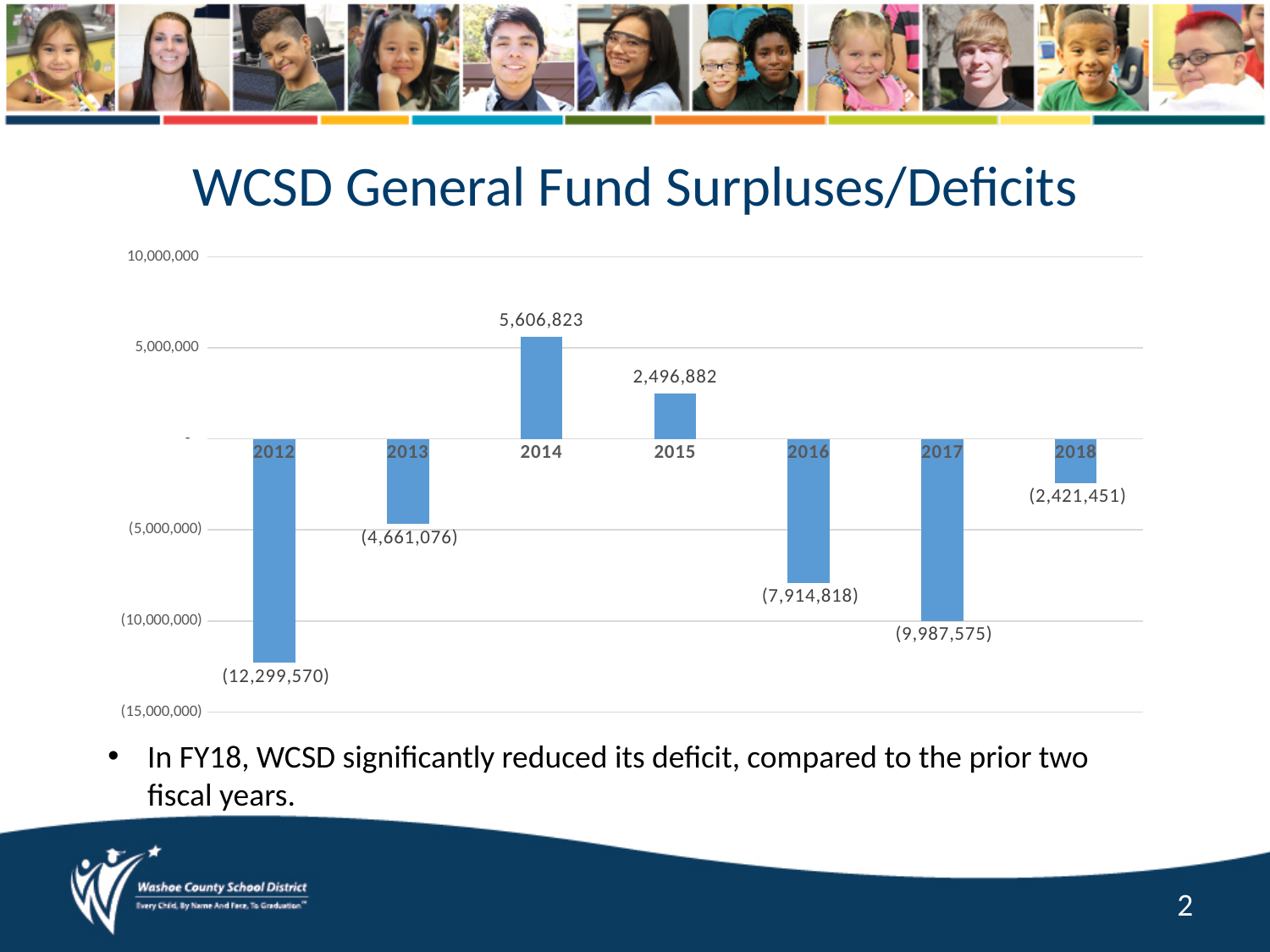
What is the value shown for 2018? (2,421,451) What is the value shown for 2016? (7,914,818) What is the title of the chart? WCSD General Fund Surpluses/Deficits What is the difference between the 2014 and 2015 values? 3,109,941 By how much does the 2017 deficit exceed the 2016 deficit? 2,072,757 What is the value shown for 2012? (12,299,570) What is the value shown for 2014? 5,606,823 Which year has the highest value? 2014 Which year has the lowest value? 2012 How many years are shown on the x axis? 7 Which is larger, the value for 2015 or the value for 2014? 2014 What kind of chart is shown on the slide? Bar chart